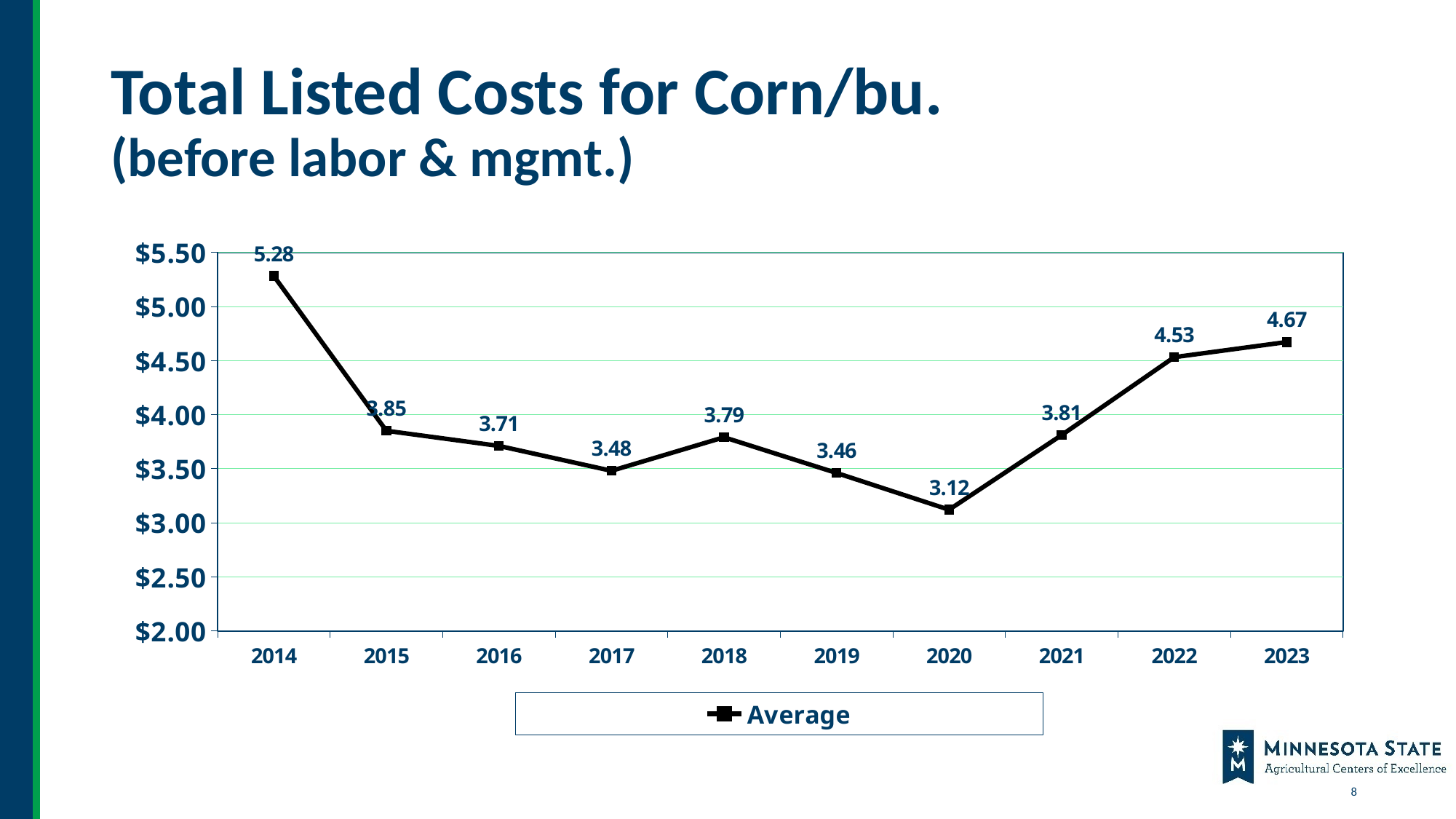
Is the value for 2022 greater or less than $4.00? greater Which year has the lowest value? 2020 What is the value for 2014? 5.28 How many years are plotted on the x axis? 10 Which year has the highest value? 2014 Which is larger, the value for 2018 or the value for 2019? 2018 How many series does the legend list? 1 What is the value for 2023? 4.67 What kind of chart is shown? line chart What is the value for 2020? 3.12 Do the values rise or fall from 2020 to 2023? rise What is the difference between the values for 2014 and 2020? 2.16